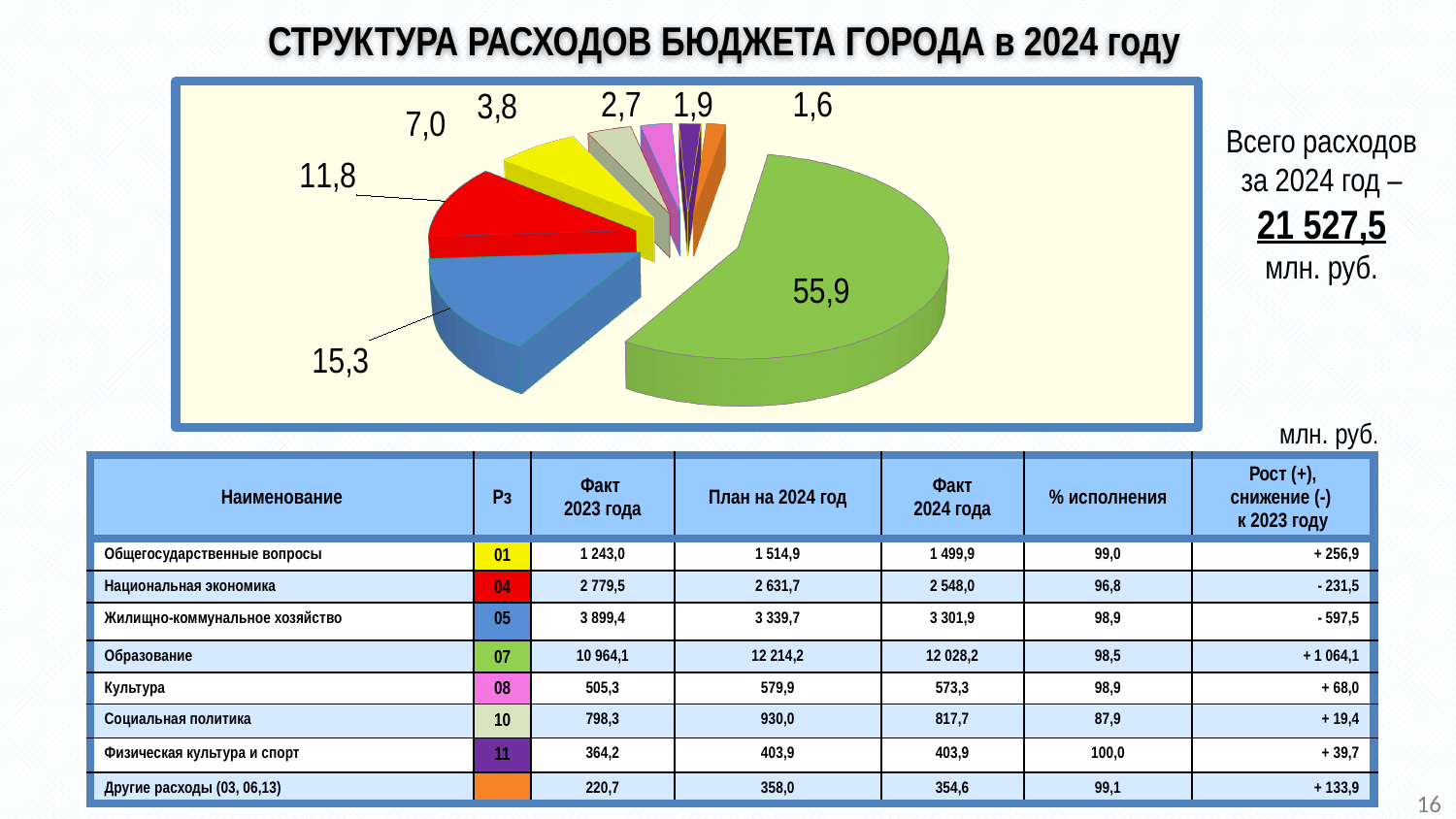
What is the difference between the green slice (55,9) and the blue slice (15,3) in the pie chart? 40,6 What value is labelled on the blue slice of the pie chart? 15,3 What value is labelled on the red slice of the pie chart? 11,8 What value is labelled on the yellow slice of the pie chart? 7,0 What total expenditure for 2024 is stated next to the pie chart? 21 527,5 млн. руб. What is the value of the largest slice of the pie chart? 55,9 How many slices does the pie chart have? 8 What kind of chart is shown on the slide? pie chart Which slice is larger in the pie chart, the red one or the yellow one? the red one (11,8) What is the title of the slide containing the pie chart? СТРУКТУРА РАСХОДОВ БЮДЖЕТА ГОРОДА в 2024 году What is the value of the smallest slice of the pie chart? 1,6 According to the pie chart, what share of expenditure goes to Образование (the green slice)? 55,9